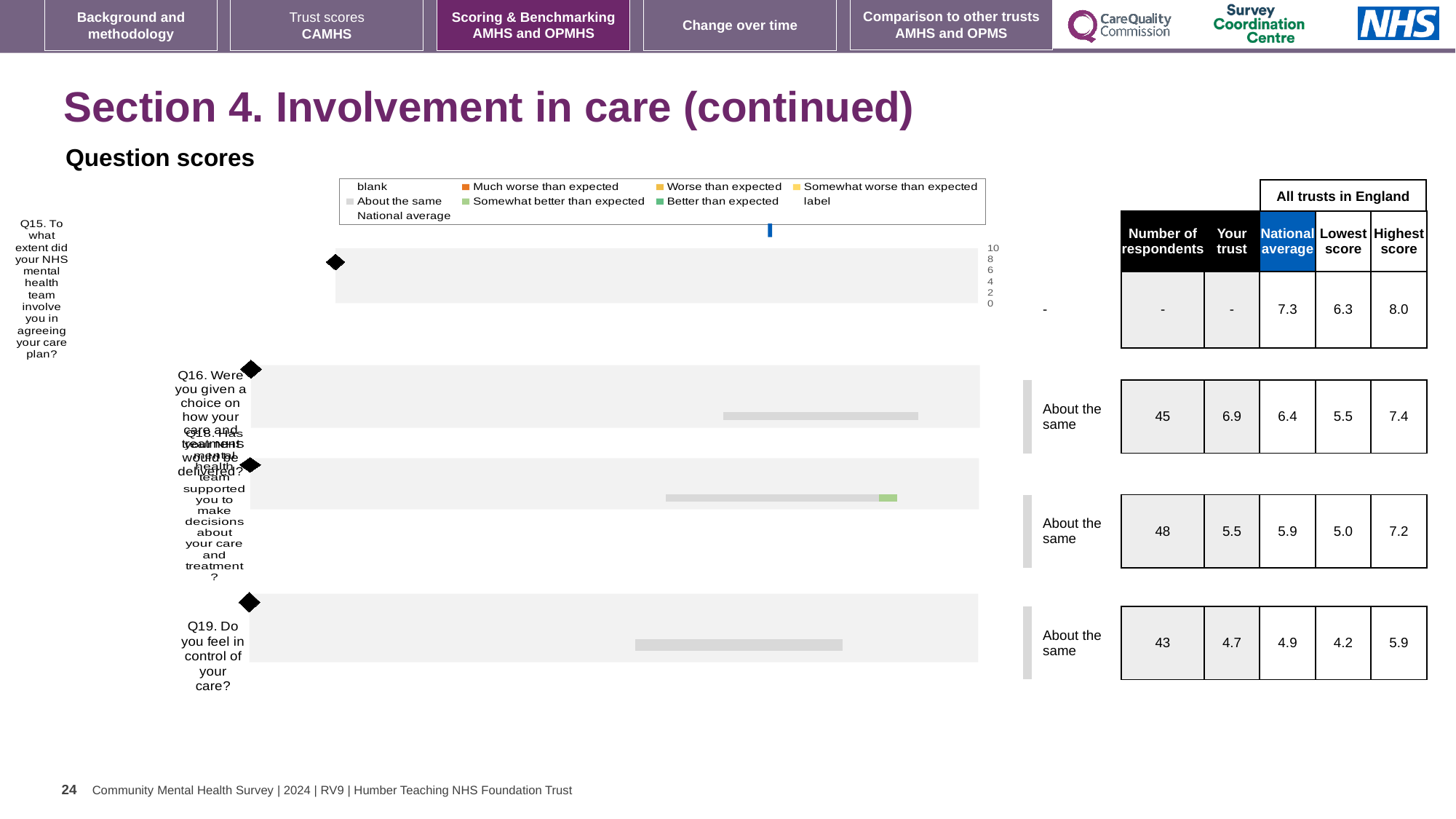
What is the highest score among all trusts in England for Q19 (Do you feel in control of your care?)? 5.9 What kind of chart is used to show the question scores? Bar chart What is the national average score for Q18 (Has your NHS mental health team supported you to make decisions about your care and treatment?)? 5.9 What is the 'Your trust' score for Q16? 6.9 What is the lowest score among all trusts in England for Q15? 6.3 Which question has the lowest 'Your trust' score? Q19 What is the difference between the 'Your trust' score and the national average for Q16? 0.5 Which question has the highest 'Your trust' score? Q16 How many questions are plotted in the chart? 4 What benchmark category is shown for Q19? About the same For Q18, which is larger: the 'Your trust' score or the national average? National average What is the number of respondents for Q16 (Were you given a choice on how your care and treatment would be delivered?)? 45